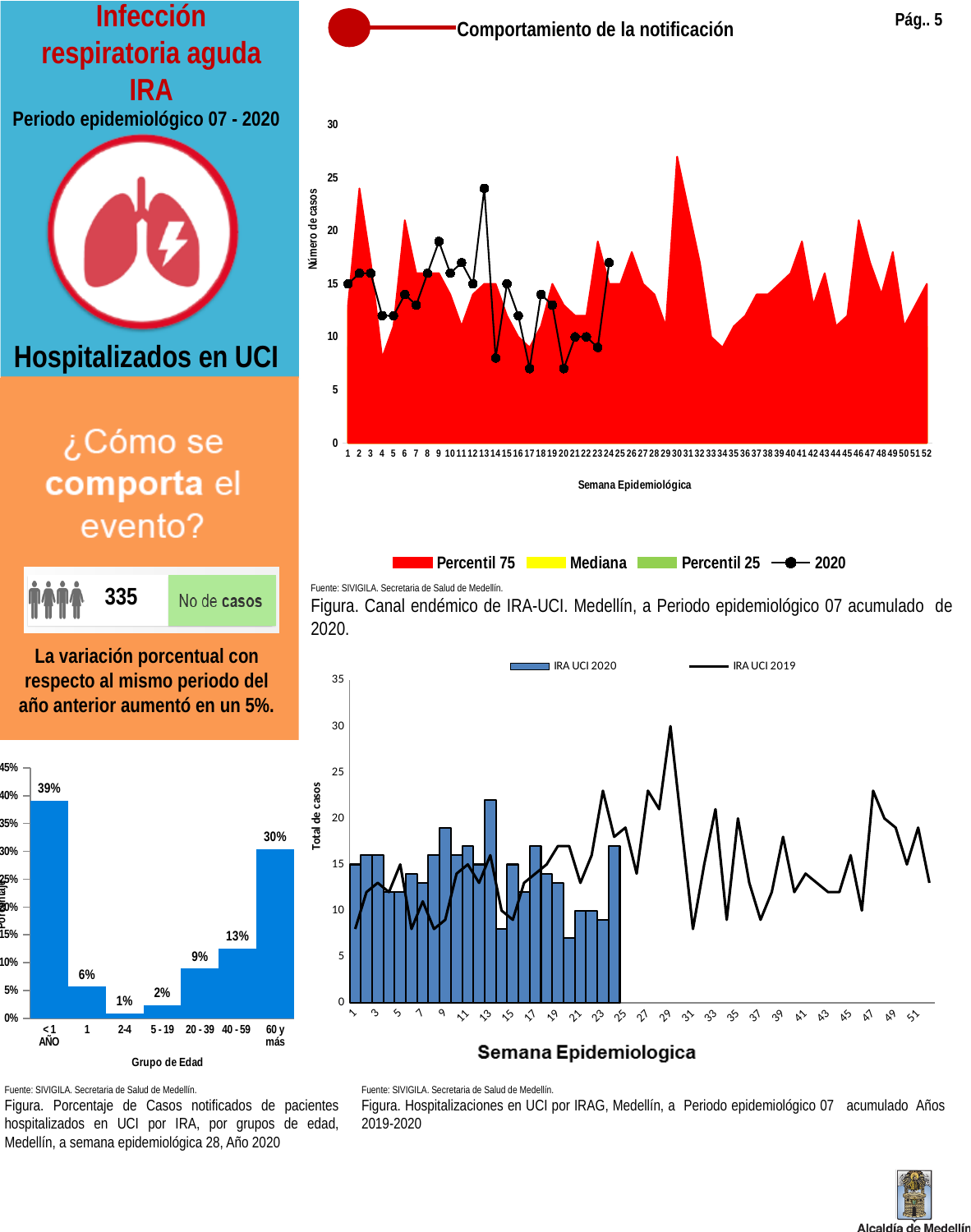
In the age group chart (bottom left), which age group has the highest percentage? < 1 AÑO In the 'Hospitalizaciones en UCI por IRAG' chart (bottom right), is the IRA UCI 2020 value for week 13 greater or less than 20? greater How many age groups are shown in the age group chart (bottom left)? 7 In the age group chart (bottom left), what percentage corresponds to the '60 y más' group? 30% What kind of chart is the age group chart at the bottom left? Bar chart In the age group chart (bottom left), what percentage of patients hospitalized in UCI are in the '< 1 AÑO' group? 39% In the age group chart (bottom left), which age group has the lowest percentage? 2-4 In the 'Hospitalizaciones en UCI por IRAG' chart (bottom right), is the IRA UCI 2019 value for week 29 greater or less than 25? greater How many series does the legend of the 'Hospitalizaciones en UCI por IRAG' chart (bottom right) list? 2 How many series does the legend of the 'Canal endémico de IRA-UCI' chart (top right) list? 4 In the age group chart (bottom left), what is the difference in percentage points between the '< 1 AÑO' group and the '60 y más' group? 9 In the age group chart (bottom left), which has a larger percentage: the '20 - 39' group or the '40 - 59' group? 40 - 59